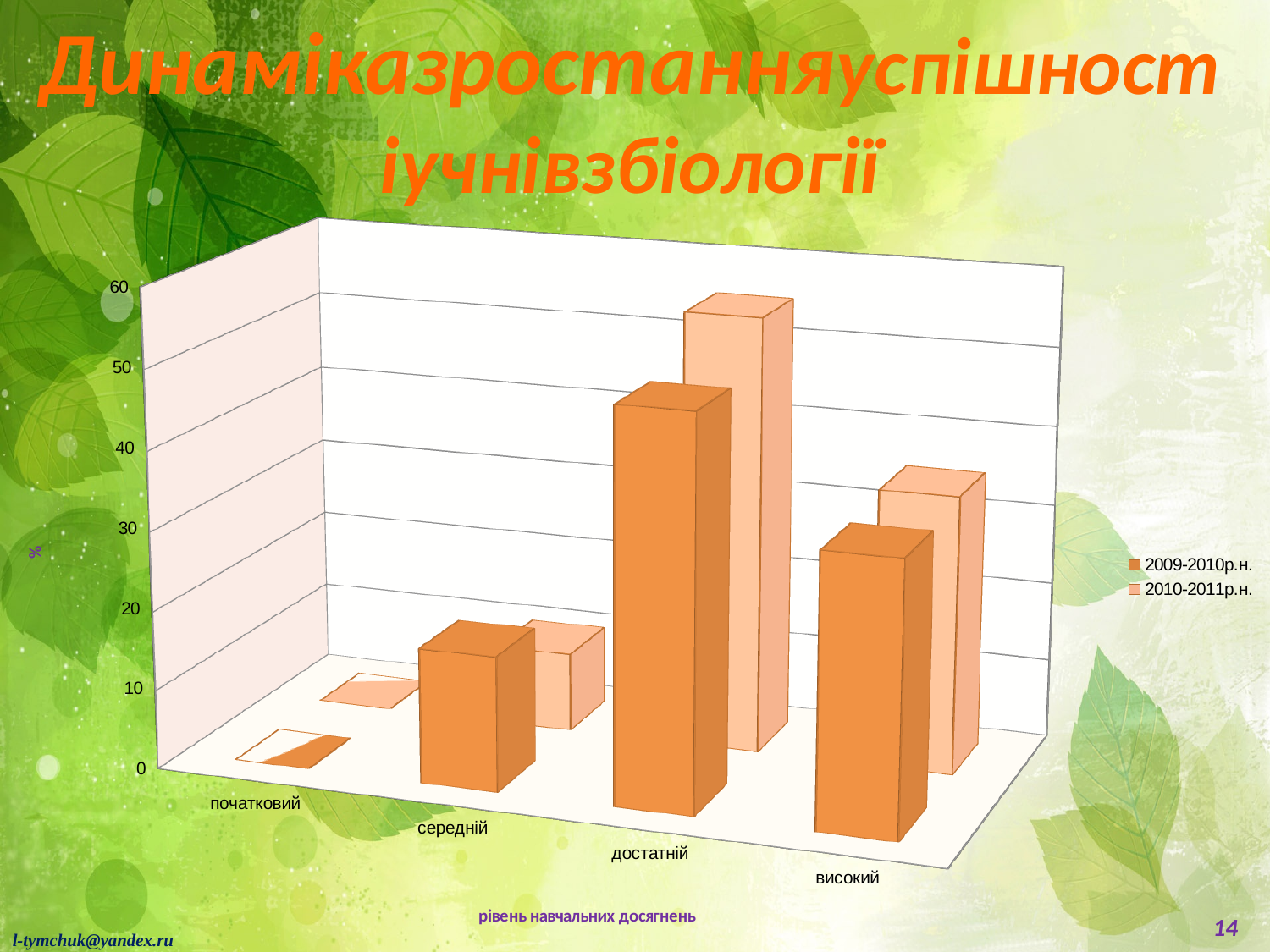
Which category has the lowest value for the 2009-2010р.н. series? початковий Is the value for середній in the 2009-2010р.н. series greater or less than 40? less Which category has the highest value for the 2009-2010р.н. series? достатній What are the two entries listed in the chart legend? 2009-2010р.н. and 2010-2011р.н. For the 2010-2011р.н. series, which is larger: високий or середній? високий For the 2009-2010р.н. series, which is larger: достатній or середній? достатній How many series does the chart legend list? 2 Is the value for достатній in the 2010-2011р.н. series greater or less than 40? greater Is the value for початковий in the 2010-2011р.н. series greater or less than 10? less Which category has the highest value for the 2010-2011р.н. series? достатній What kind of chart is shown on the slide? bar chart How many categories are shown on the x axis of the chart? 4